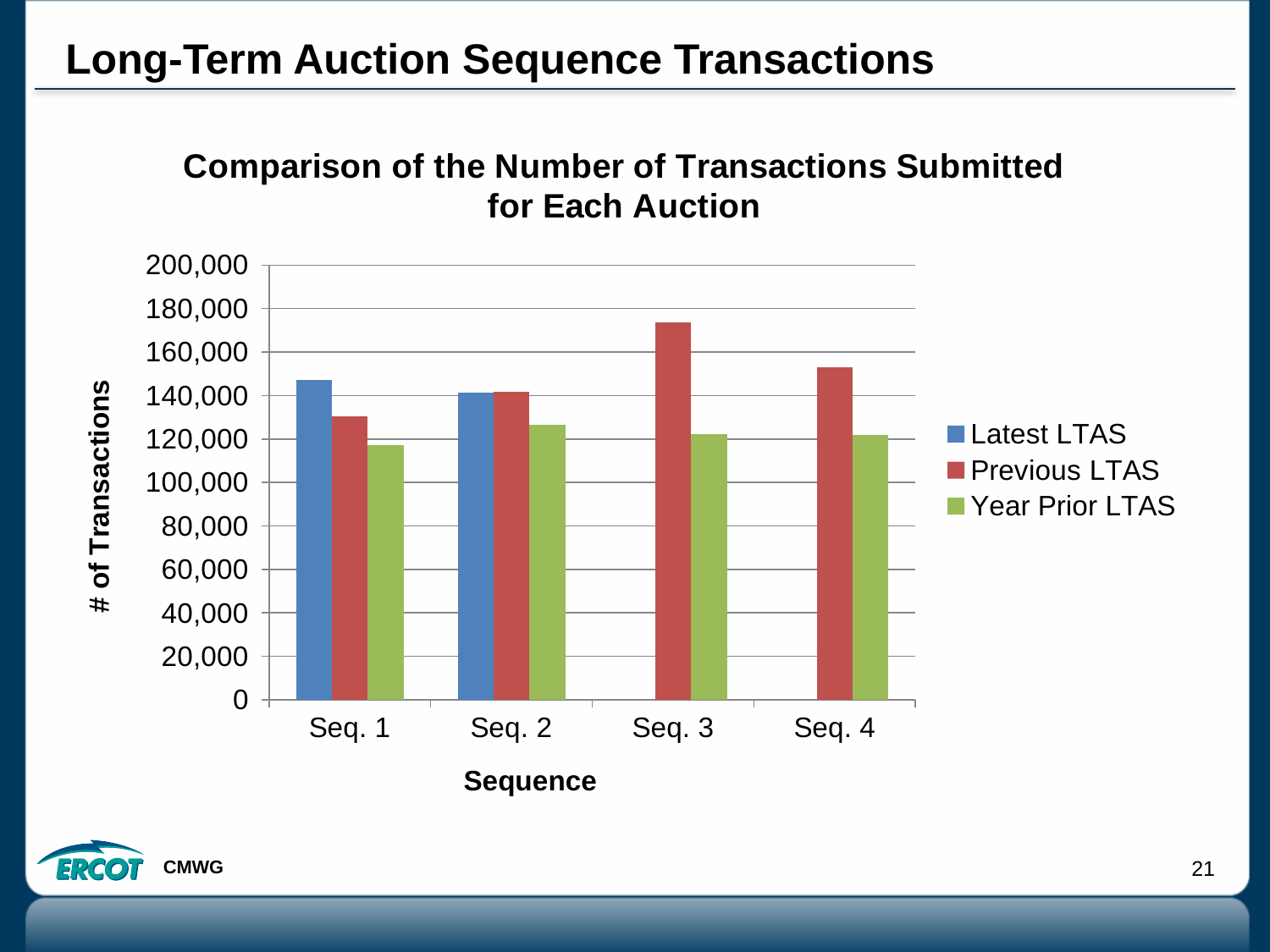
Does the Previous LTAS value rise or fall from Seq. 1 to Seq. 3? rise For Seq. 1, which is larger: Latest LTAS or Previous LTAS? Latest LTAS How many sequence categories are shown on the x axis? 4 For which sequence is the Year Prior LTAS value lowest? Seq. 1 How many series does the legend list? 3 Is the Year Prior LTAS value for Seq. 1 greater or less than 120,000? less For which sequence is the Previous LTAS value highest? Seq. 3 Is the Previous LTAS value for Seq. 3 greater or less than 160,000? greater For Seq. 3, which is larger: Previous LTAS or Year Prior LTAS? Previous LTAS Is the Latest LTAS value for Seq. 1 greater or less than 140,000? greater What is the label on the vertical axis of the chart? # of Transactions What kind of chart is shown on the slide? Bar chart